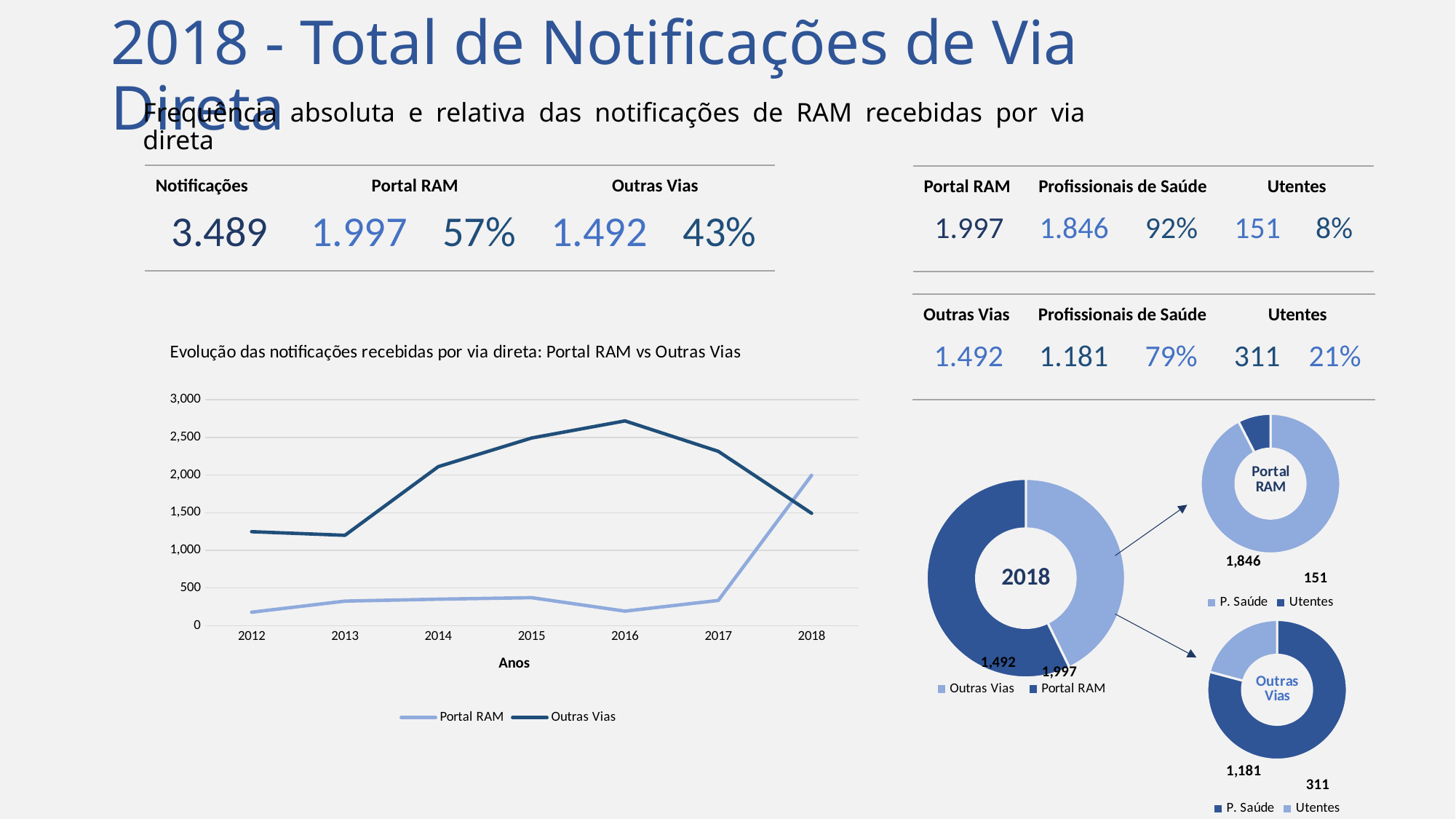
In the line chart 'Evolução das notificações recebidas por via direta', is the value for Outras Vias in 2016 greater or less than 2,500? greater In the donut chart labelled 'Portal RAM', what is the value for Utentes? 151 In the donut chart labelled '2018', what is the difference between Portal RAM and Outras Vias? 505 In the line chart 'Evolução das notificações recebidas por via direta', does the Portal RAM series rise or fall from 2017 to 2018? rise In the line chart 'Evolução das notificações recebidas por via direta', is the value for Portal RAM in 2017 greater or less than 500? less In the line chart 'Evolução das notificações recebidas por via direta', which series has the larger value in 2018, Portal RAM or Outras Vias? Portal RAM How many years are shown on the x axis of the line chart 'Evolução das notificações recebidas por via direta'? 7 In the donut chart labelled 'Outras Vias', what is the value for P. Saúde? 1,181 In the donut chart labelled '2018', what is the value for Portal RAM? 1,997 What kind of chart is 'Evolução das notificações recebidas por via direta: Portal RAM vs Outras Vias'? line chart How many series does the legend of the line chart 'Evolução das notificações recebidas por via direta' list? 2 In the line chart 'Evolução das notificações recebidas por via direta', in which year does Outras Vias reach its highest value? 2016